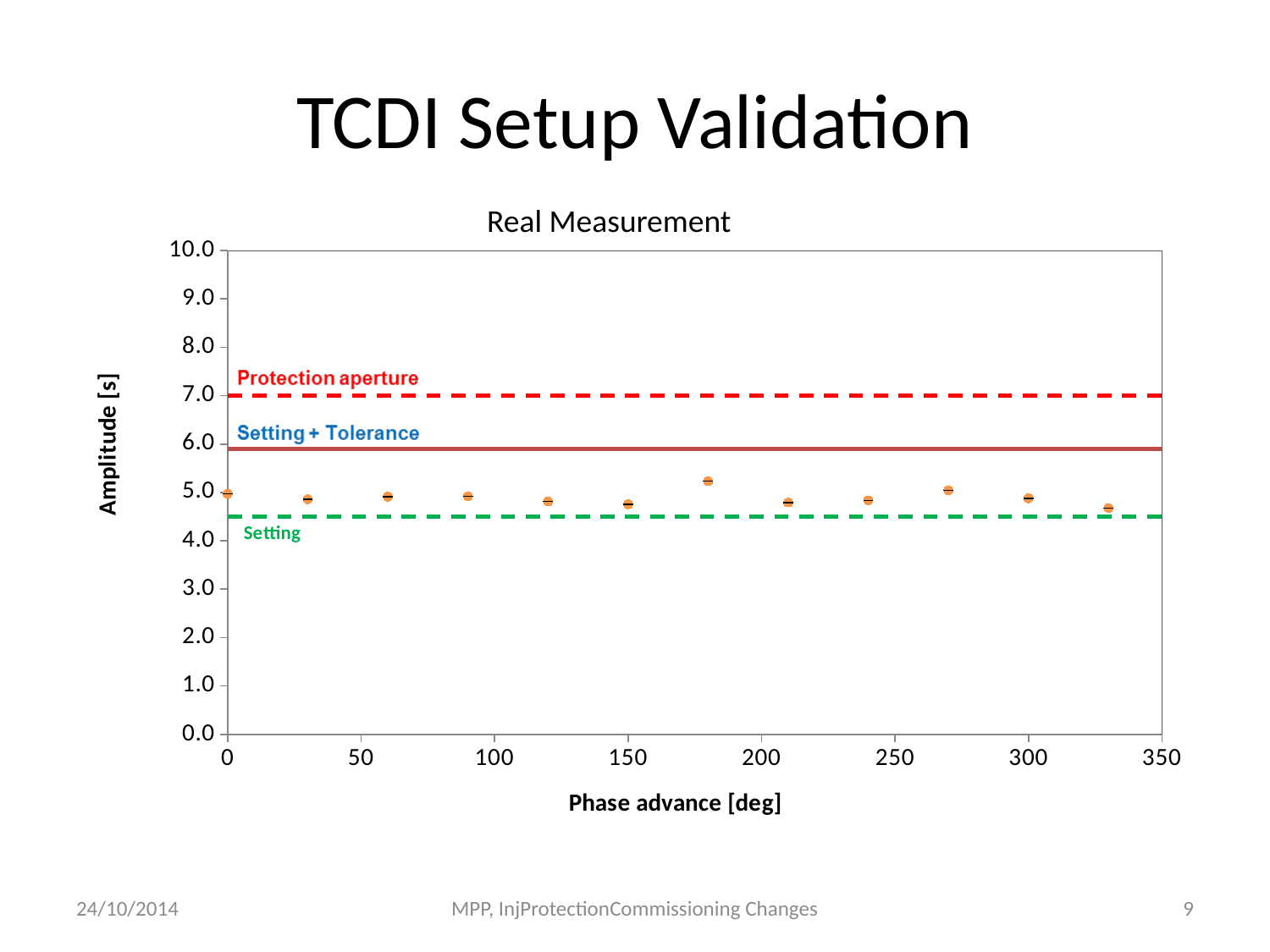
Is the measured amplitude at a phase advance of 330 deg greater or less than 5.0? less What is the title of the chart? Real Measurement What kind of chart is shown on the slide? scatter chart Is the measured amplitude at a phase advance of 150 deg greater or less than 5.0? less Which has the larger measured amplitude: the point at 180 deg or the point at 330 deg? 180 deg What is the label of the y axis? Amplitude [s] At what amplitude value is the Protection aperture line drawn? 7.0 Which has the larger measured amplitude: the point at 0 deg or the point at 330 deg? 0 deg How many measurement points are plotted in the chart? 12 Are all the measured amplitudes greater or less than 6.0? less At which phase advance is the measured amplitude highest? 180